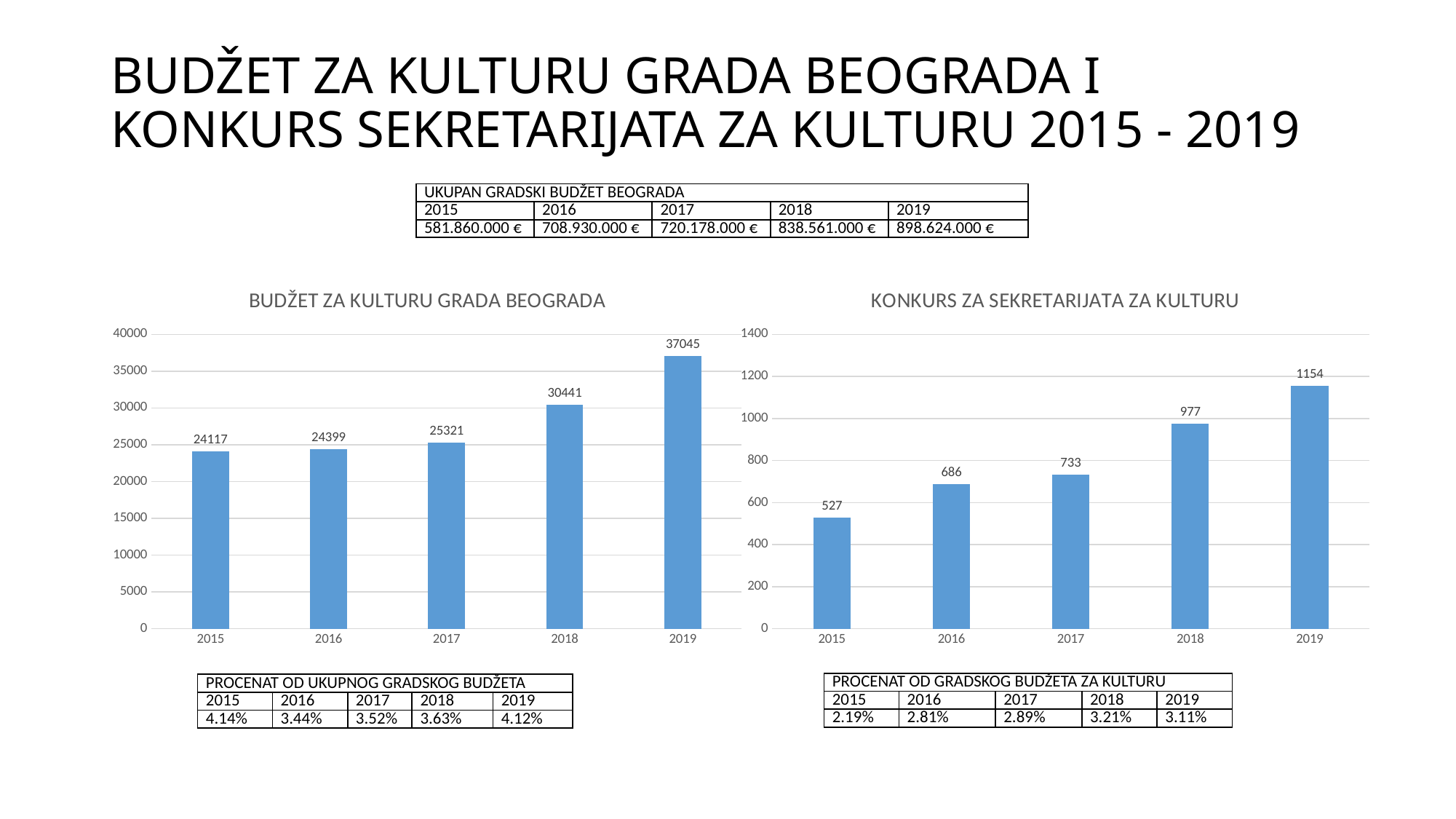
In the 'KONKURS ZA SEKRETARIJATA ZA KULTURU' chart, which year has the lowest value? 2015 In the 'KONKURS ZA SEKRETARIJATA ZA KULTURU' chart, which is larger, the value for 2017 or the value for 2018? 2018 How many years are shown on the x axis of the 'KONKURS ZA SEKRETARIJATA ZA KULTURU' chart? 5 In the 'BUDŽET ZA KULTURU GRADA BEOGRADA' chart, what is the difference between the values for 2019 and 2018? 6604 In the 'KONKURS ZA SEKRETARIJATA ZA KULTURU' chart, what is the difference between the values for 2018 and 2017? 244 In the 'KONKURS ZA SEKRETARIJATA ZA KULTURU' chart, what is the value for 2016? 686 What is the title of the chart on the right side of the slide? KONKURS ZA SEKRETARIJATA ZA KULTURU In the 'BUDŽET ZA KULTURU GRADA BEOGRADA' chart, is the value for 2018 greater or less than 30000? greater In the 'BUDŽET ZA KULTURU GRADA BEOGRADA' chart, what is the value for 2017? 25321 In the 'BUDŽET ZA KULTURU GRADA BEOGRADA' chart, which year has the highest value? 2019 What kind of chart is the 'BUDŽET ZA KULTURU GRADA BEOGRADA' chart? bar chart In the 'KONKURS ZA SEKRETARIJATA ZA KULTURU' chart, do the values rise or fall from 2015 to 2019? rise